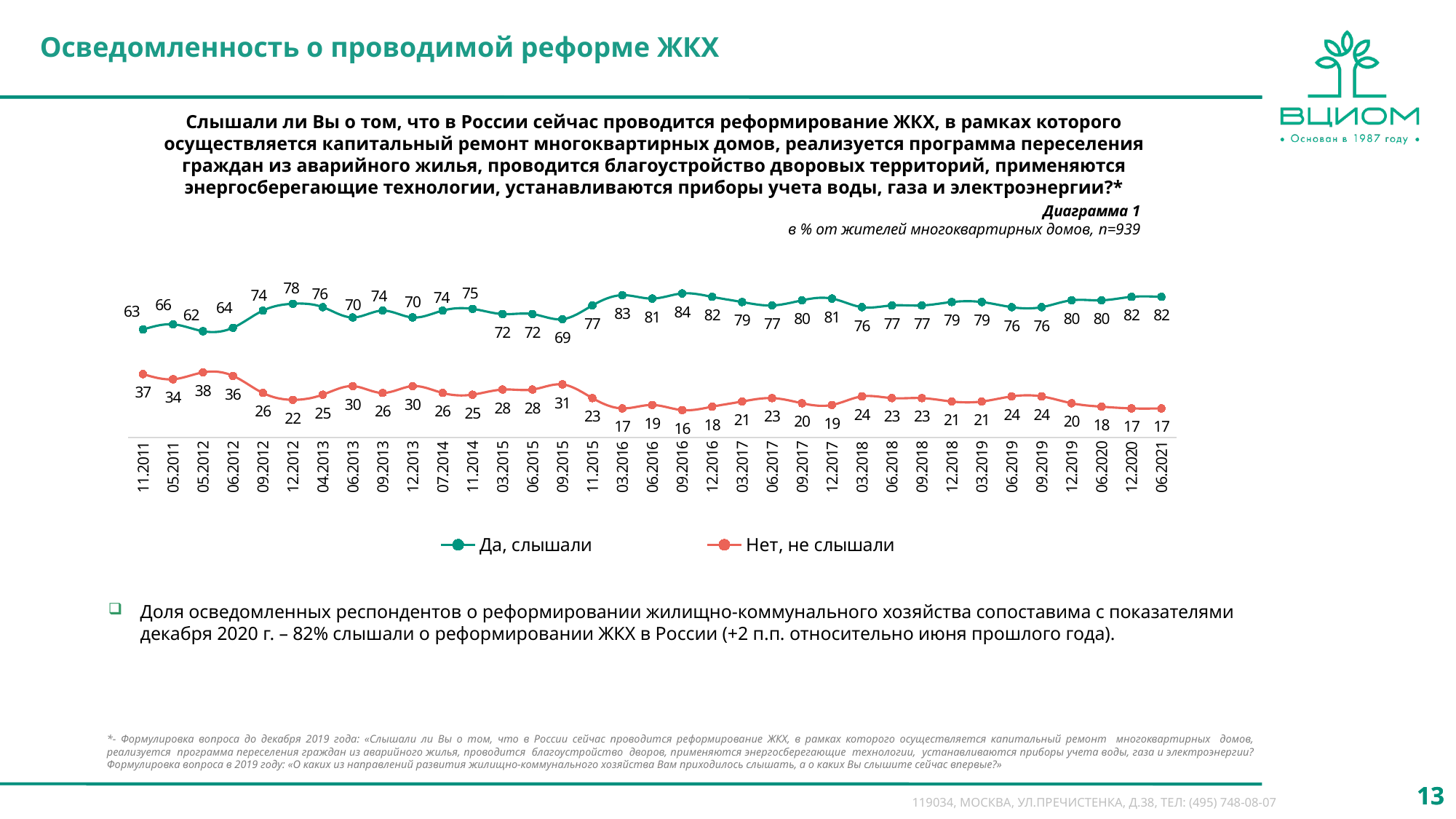
What is the value for "Нет, не слышали" in 12.2012? 22 In which period does "Да, слышали" reach its highest value? 09.2016 What is the value for "Да, слышали" in 09.2015? 69 What is the sample size (n) stated in the chart subtitle? n=939 In which period does "Нет, не слышали" reach its highest value? 05.2012 What is the value for "Да, слышали" in 06.2021? 82 Which is larger: "Нет, не слышали" in 09.2015 or in 11.2015? 09.2015 In which period does "Да, слышали" have its lowest value? 05.2012 What type of chart is shown on the slide? line chart How many time points are plotted on the x axis? 35 What is the difference between "Да, слышали" and "Нет, не слышали" in 11.2011? 26 How many series does the legend list? 2